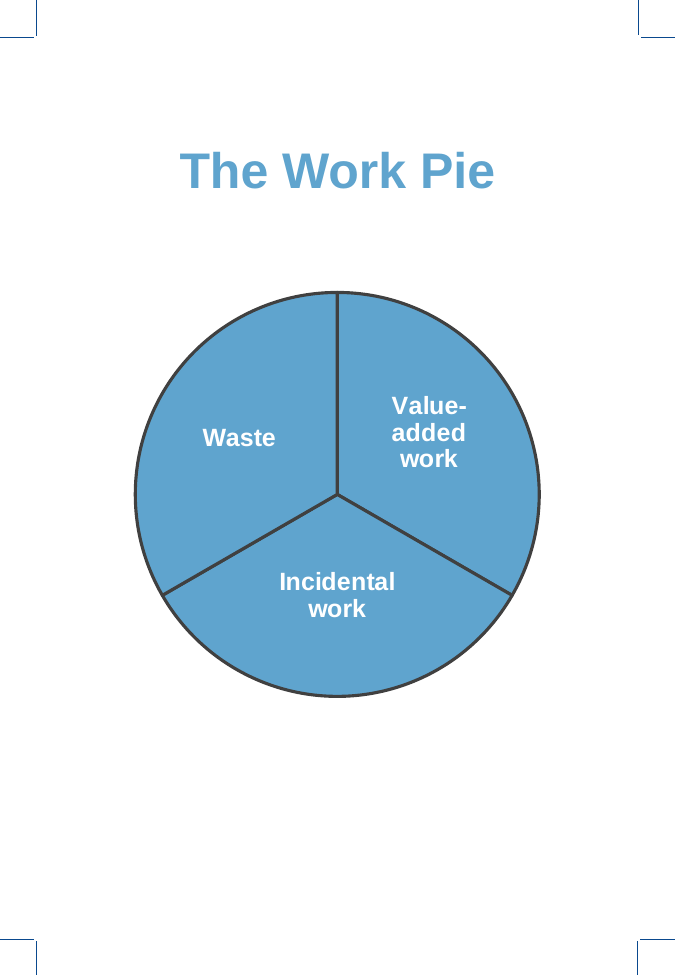
How many slices does the pie chart have? 3 Is the slice labelled "Waste" clearly larger than the slice labelled "Value-added work", or are they about the same size? about the same size What is the title of the chart? The Work Pie What kind of chart is shown on the slide? pie chart Which slice is labelled at the bottom of the pie? Incidental work